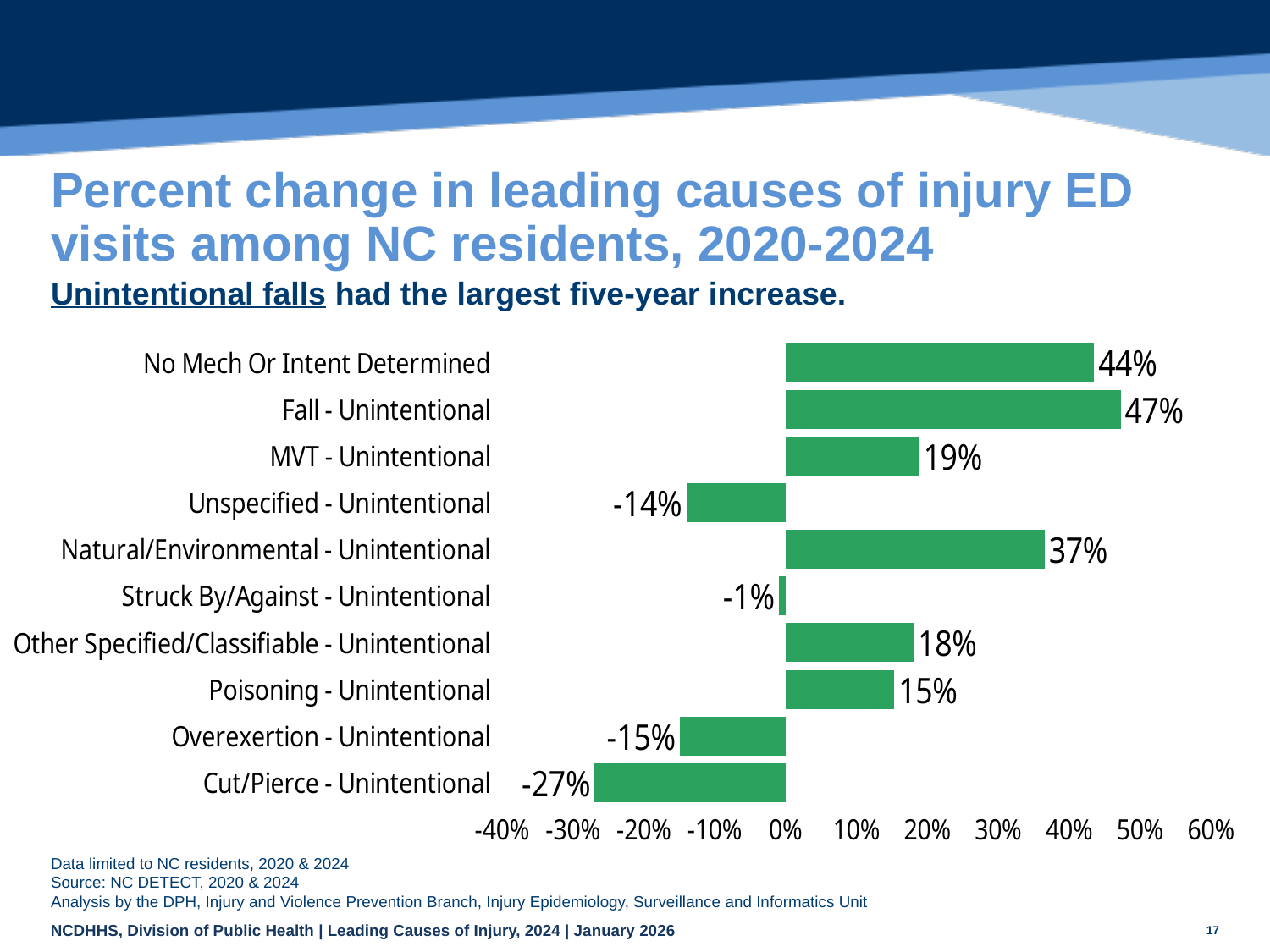
What is the percent change for Fall - Unintentional? 47% What is the difference between the percent change for Fall - Unintentional and No Mech Or Intent Determined? 3% What is the percent change for Cut/Pierce - Unintentional? -27% Which is larger, the percent change for MVT - Unintentional or Poisoning - Unintentional? MVT - Unintentional What is the difference between the percent change for Overexertion - Unintentional and Unspecified - Unintentional? 1% What kind of chart is shown on the slide? Bar chart How many categories show a negative percent change? 4 How many categories are shown in the chart? 10 Which category has the highest percent change? Fall - Unintentional Which category has the lowest percent change? Cut/Pierce - Unintentional What is the percent change for Natural/Environmental - Unintentional? 37% What is the percent change for Struck By/Against - Unintentional? -1%